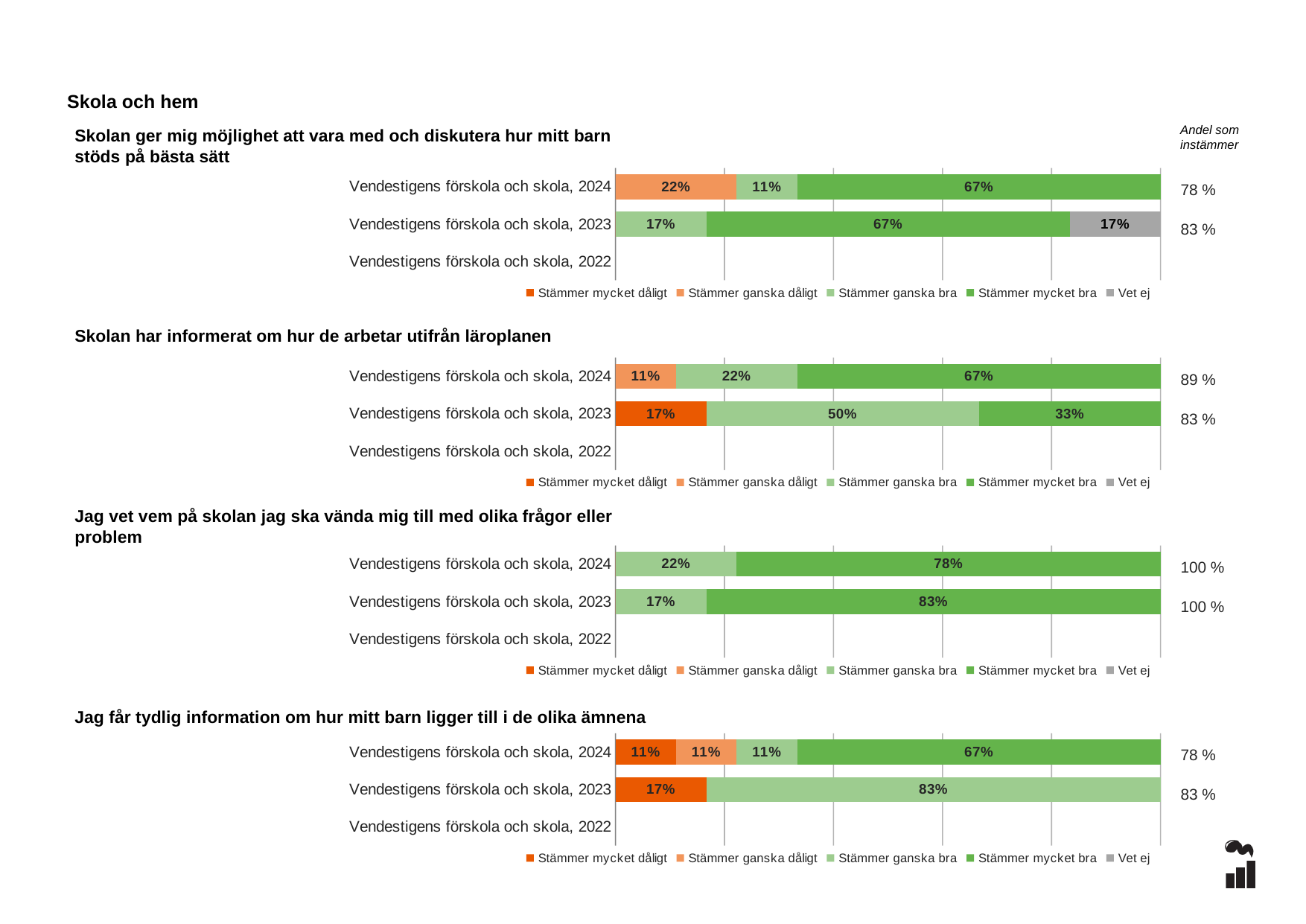
How many category rows are shown in the chart 'Jag får tydlig information om hur mitt barn ligger till i de olika ämnena'? 3 In the chart 'Jag får tydlig information om hur mitt barn ligger till i de olika ämnena', what is the difference between the 'Stämmer mycket bra' value for 2024 and the 'Stämmer ganska bra' value for 2024? 56% In the chart 'Jag får tydlig information om hur mitt barn ligger till i de olika ämnena', what is the 'Stämmer mycket dåligt' value for Vendestigens förskola och skola, 2023? 17% In the chart 'Skolan ger mig möjlighet att vara med och diskutera hur mitt barn stöds på bästa sätt', what is the 'Stämmer mycket bra' value for Vendestigens förskola och skola, 2024? 67% In the chart 'Skolan har informerat om hur de arbetar utifrån läroplanen', which is larger: the 'Stämmer mycket bra' value for 2024 or for 2023? 2024 What kind of chart is 'Skolan har informerat om hur de arbetar utifrån läroplanen'? Stacked bar chart In the chart 'Skolan har informerat om hur de arbetar utifrån läroplanen', what is the 'Andel som instämmer' for Vendestigens förskola och skola, 2024? 89 % In the chart 'Skolan har informerat om hur de arbetar utifrån läroplanen', what is the 'Stämmer ganska bra' value for Vendestigens förskola och skola, 2023? 50% In the chart 'Jag vet vem på skolan jag ska vända mig till med olika frågor eller problem', what is the 'Stämmer mycket bra' value for Vendestigens förskola och skola, 2023? 83% In the chart 'Jag vet vem på skolan jag ska vända mig till med olika frågor eller problem', which row has the highest 'Stämmer mycket bra' value? Vendestigens förskola och skola, 2023 How many series does the legend of the chart 'Skolan ger mig möjlighet att vara med och diskutera hur mitt barn stöds på bästa sätt' list? 5 In the chart 'Skolan ger mig möjlighet att vara med och diskutera hur mitt barn stöds på bästa sätt', what is the 'Vet ej' value for Vendestigens förskola och skola, 2023? 17%